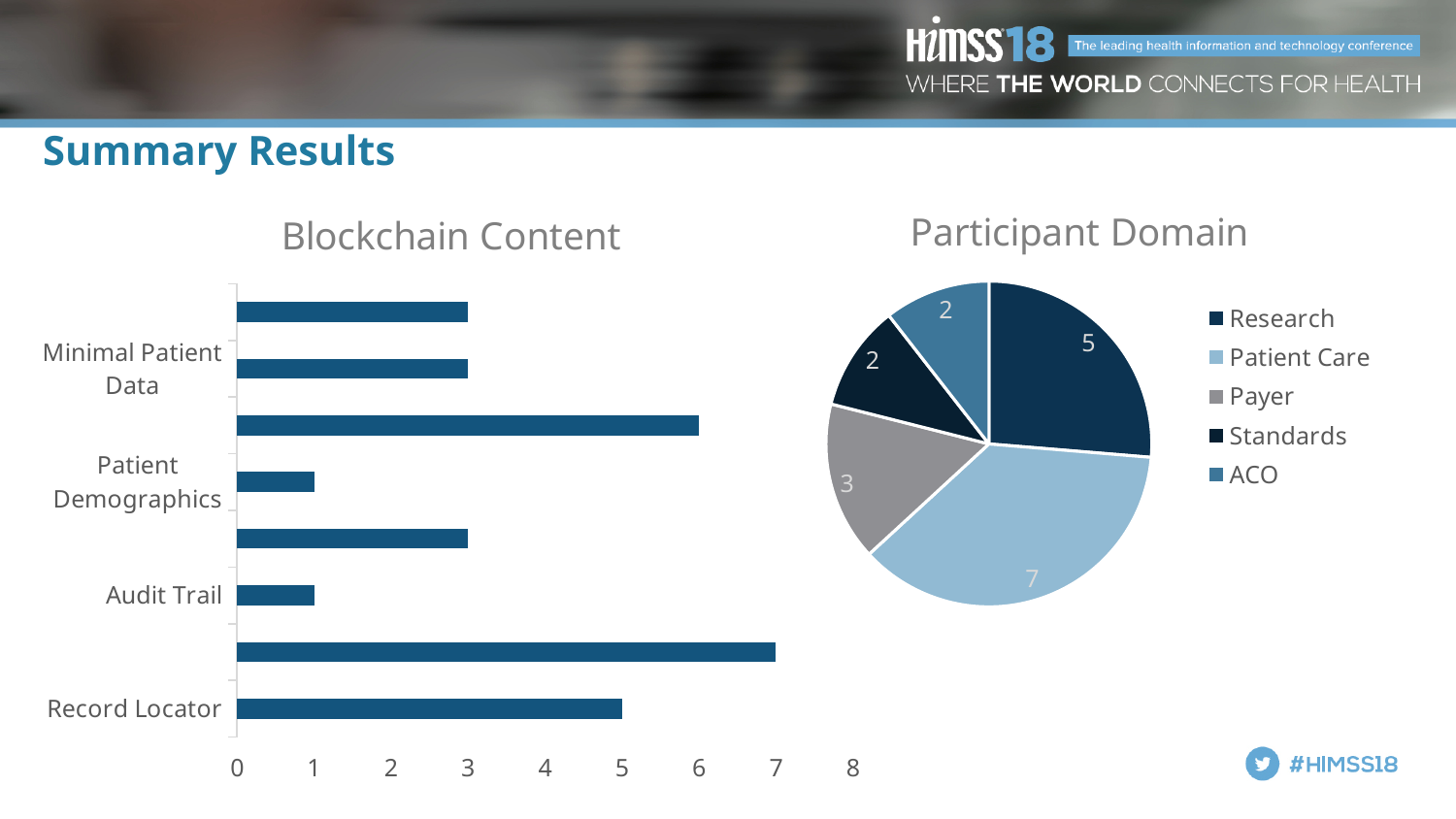
In the Participant Domain pie chart, what is the value for Payer? 3 In the Blockchain Content chart, what is the value of the longest bar? 7 In the Blockchain Content chart, what is the value for Record Locator? 5 How many bars are plotted in the Blockchain Content chart? 8 In the Participant Domain pie chart, what is the value for Patient Care? 7 How many entries does the legend of the Participant Domain chart list? 5 In the Participant Domain pie chart, what is the difference between the Patient Care and Research values? 2 In the Participant Domain pie chart, which is larger, Payer or Standards? Payer What kind of chart is the Participant Domain chart? Pie chart What kind of chart is the Blockchain Content chart? Bar chart In the Participant Domain pie chart, what is the value for Research? 5 In the Participant Domain pie chart, which domain has the largest slice? Patient Care